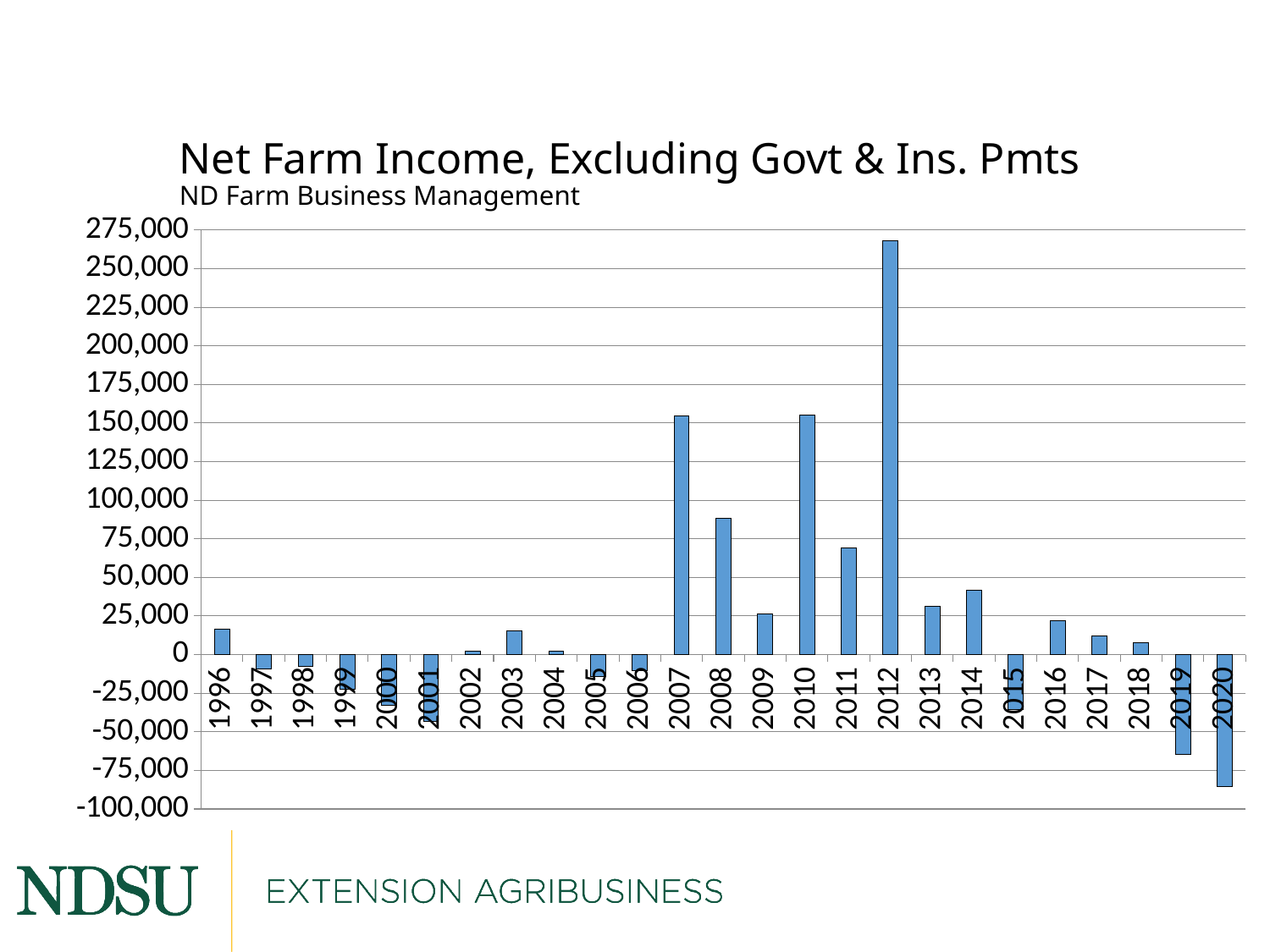
Which year has the lowest net farm income? 2020 Which year has the larger value, 2008 or 2011? 2008 What subtitle appears under the chart title? ND Farm Business Management Which year has the highest net farm income? 2012 Do the values rise or fall from 2016 to 2020? fall Is the value for 2008 greater or less than 75,000? greater Is the value for 2012 greater or less than 250,000? greater What is the title of the chart? Net Farm Income, Excluding Govt & Ins. Pmts What kind of chart is shown on the slide? Bar chart Is the value for 2019 greater or less than -50,000? less How many years are shown on the x axis? 25